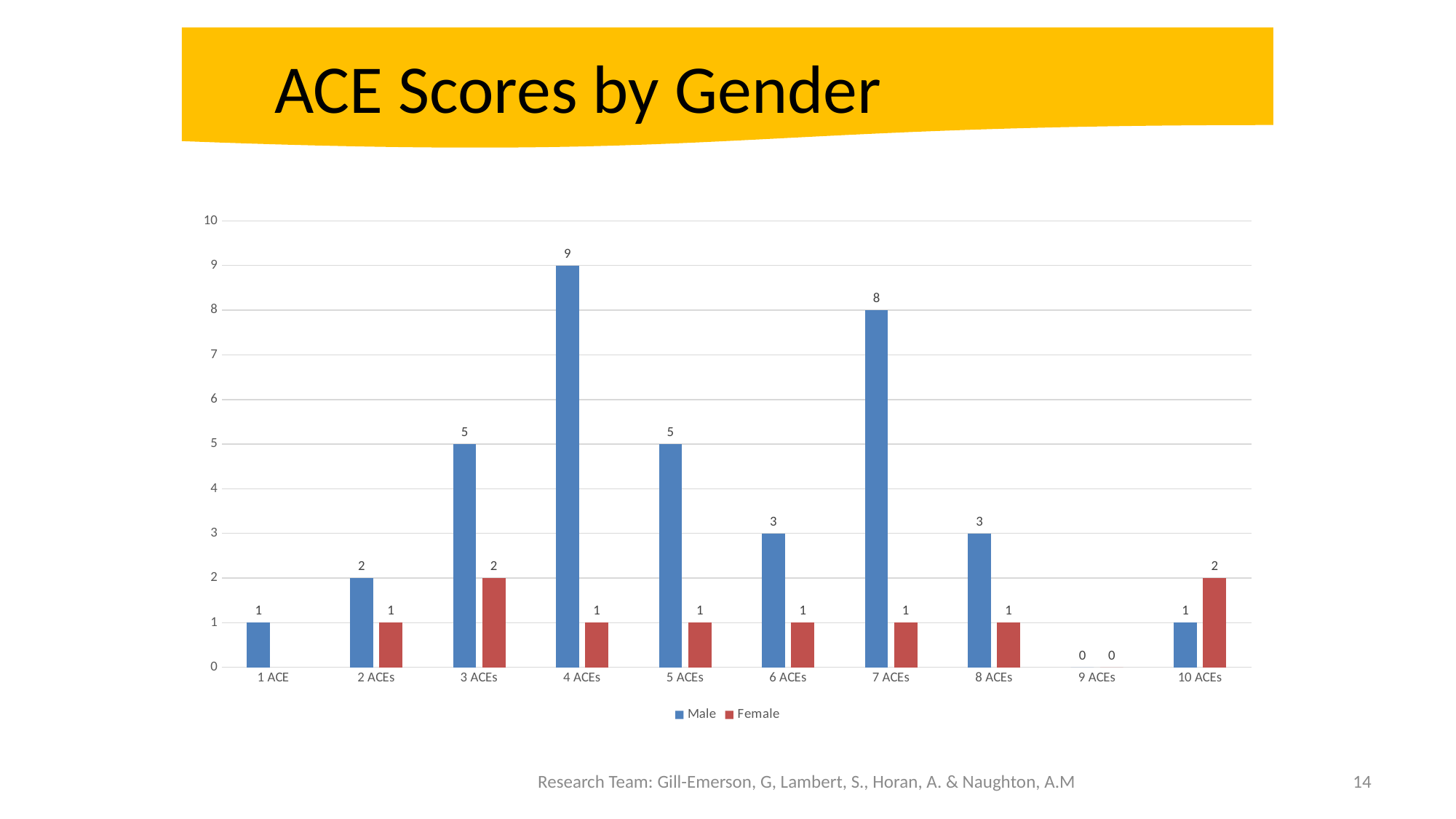
What is the Male value for 7 ACEs? 8 What is the difference between the Male and Female values for 4 ACEs? 8 How many categories are shown on the x axis? 10 What is the total of the Male and Female values for 3 ACEs? 7 Which category has the highest Male value? 4 ACEs What is the title of the slide? ACE Scores by Gender How many series does the legend list? 2 Which is larger, the Male value for 10 ACEs or the Female value for 10 ACEs? Female Which category has the lowest Male value? 9 ACEs What is the Male value for 4 ACEs? 9 What kind of chart is shown on the slide? Bar chart What is the Female value for 3 ACEs? 2